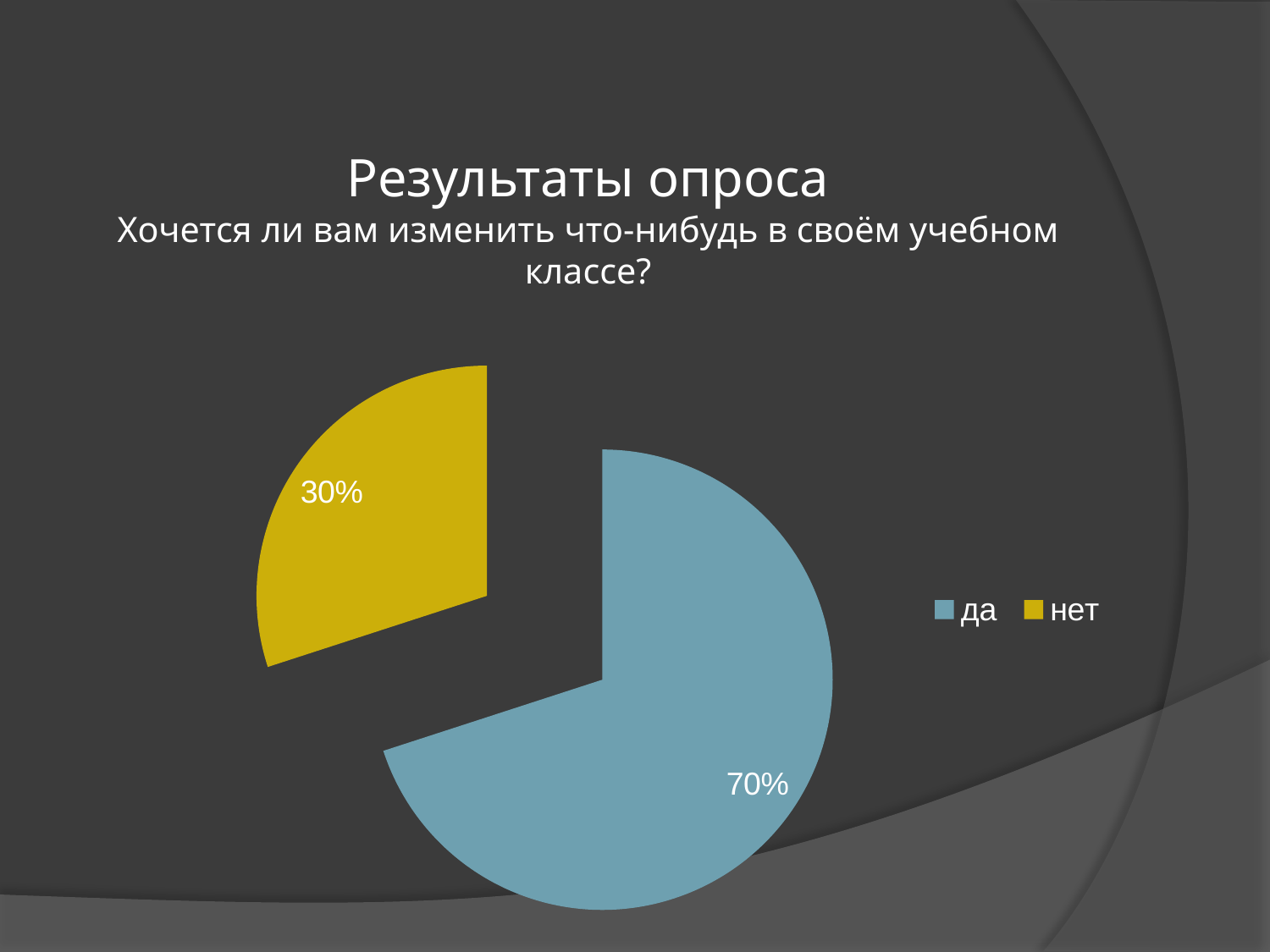
What colour is the "нет" slice? yellow How many entries does the legend list? 2 Which slice is the largest in the pie chart? да How many slices does the pie chart have? 2 What share of the pie does the "нет" slice represent? 30% Which is larger, the "да" slice or the "нет" slice? да What is the difference in percentage points between the "да" and "нет" slices? 40% Which slice is the smallest in the pie chart? нет What kind of chart is shown on the slide? pie chart What question is the survey chart about, according to the slide subtitle? Хочется ли вам изменить что-нибудь в своём учебном классе? What share of the pie does the "да" slice represent? 70%